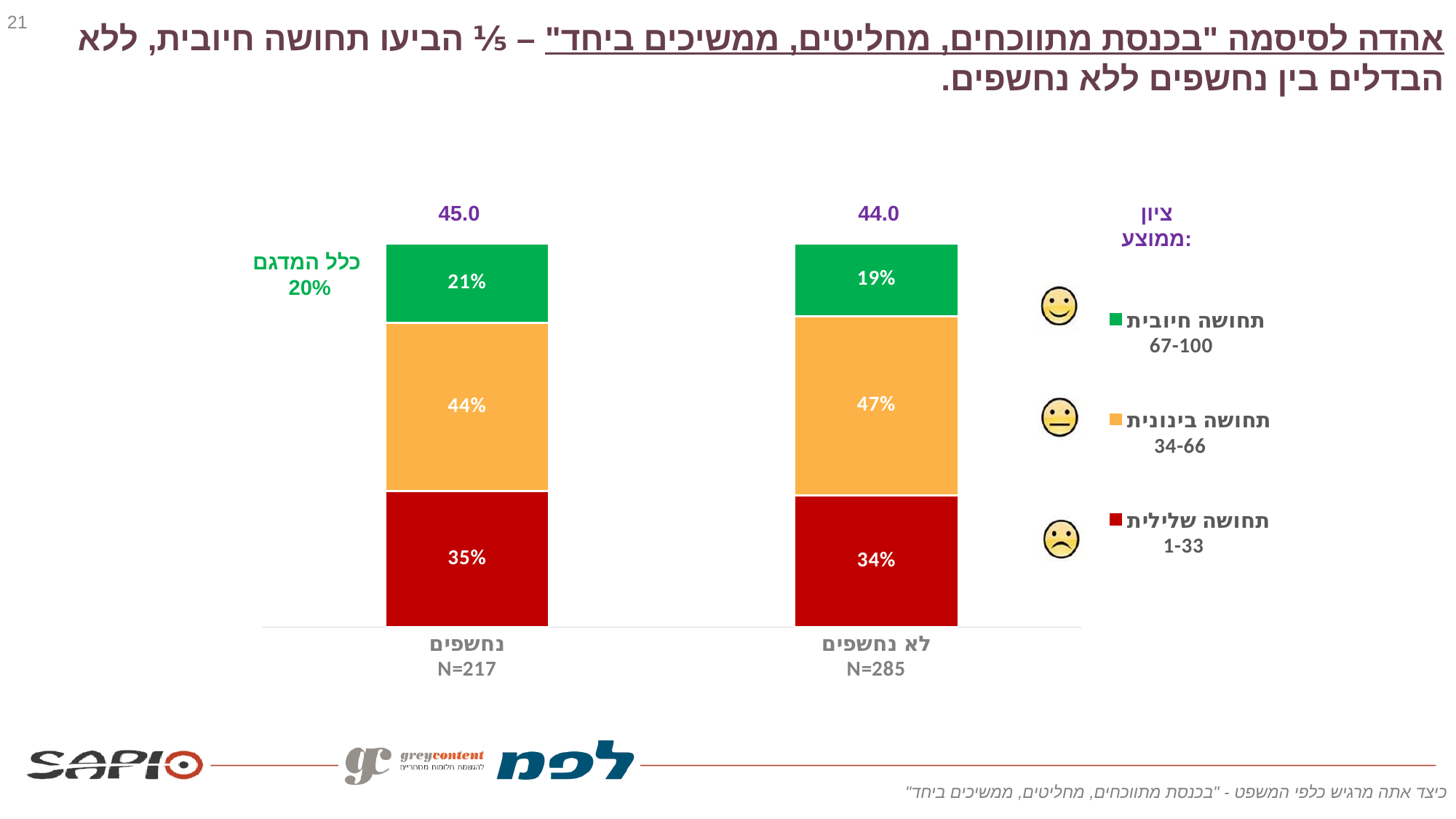
How many groups (bars) are shown in the chart? 2 Which segment is the smallest within the לא נחשפים bar? תחושה חיובית What percentage of the נחשפים group reported תחושה חיובית? 21% How many series does the legend list? 3 Which group has the higher share of תחושה בינונית, נחשפים or לא נחשפים? לא נחשפים What type of chart is shown on the slide? Stacked bar chart Which segment is the largest within the נחשפים bar? תחושה בינונית What is the average score (ציון ממוצע) shown above the נחשפים bar? 45.0 What percentage of the לא נחשפים group reported תחושה בינונית? 47% What is the average score (ציון ממוצע) shown above the לא נחשפים bar? 44.0 What percentage of the לא נחשפים group reported תחושה שלילית? 34% What is the difference in the תחושה חיובית share between נחשפים and לא נחשפים? 2 percentage points